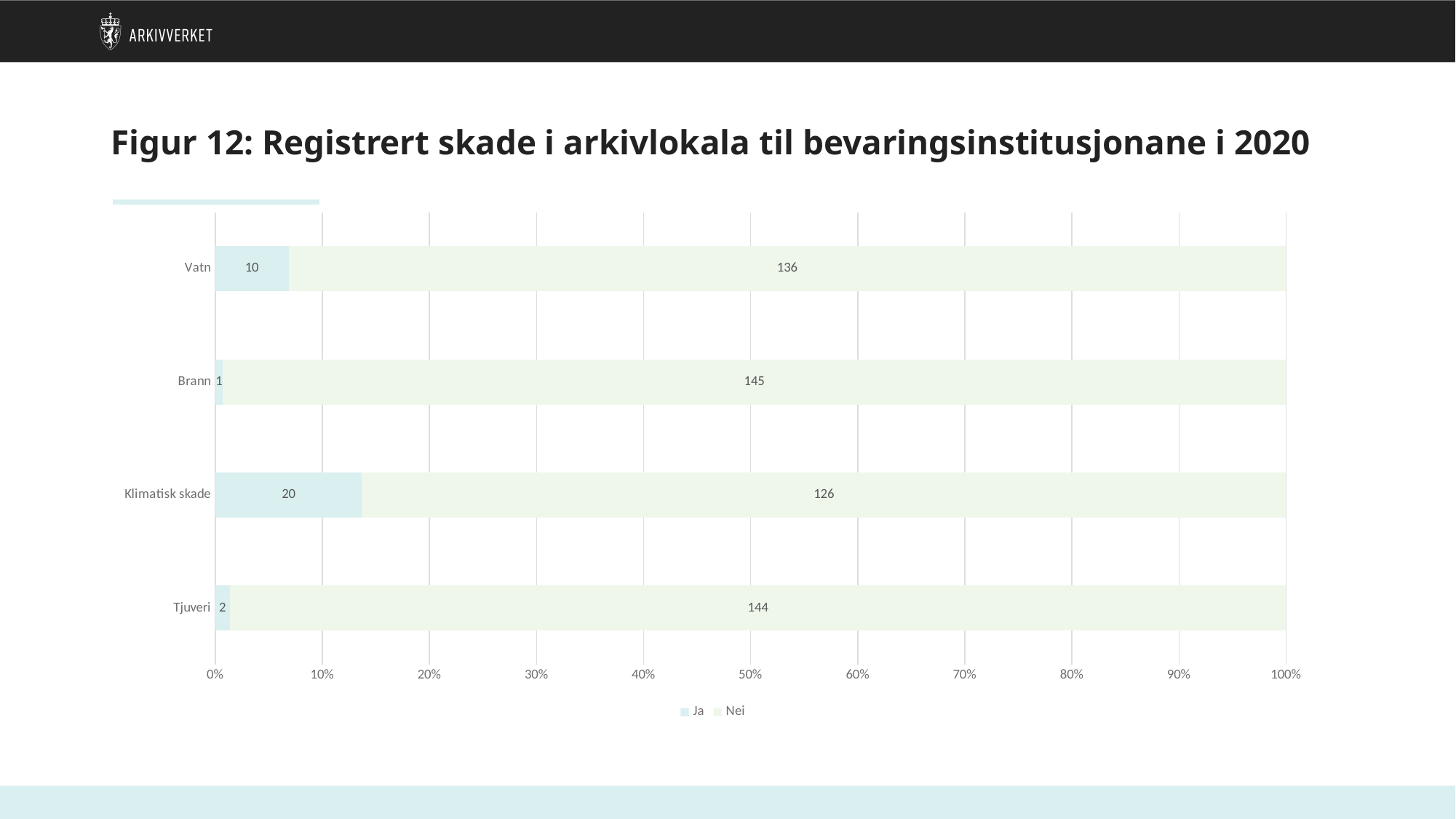
What is the 'Nei' value for Tjuveri? 144 What is the difference between the 'Nei' values for Brann and Klimatisk skade? 19 What is the 'Nei' value for Brann? 145 How many series does the legend list? 2 What kind of chart is shown on the slide? Stacked bar chart Which category has the lowest 'Ja' value? Brann What is the total of the 'Ja' and 'Nei' values for Vatn? 146 How many categories are shown on the chart? 4 Which category has the highest 'Ja' value? Klimatisk skade What is the 'Ja' value for Klimatisk skade? 20 Which is larger, the 'Ja' value for Vatn or the 'Ja' value for Tjuveri? Vatn What is the 'Ja' value for Vatn? 10